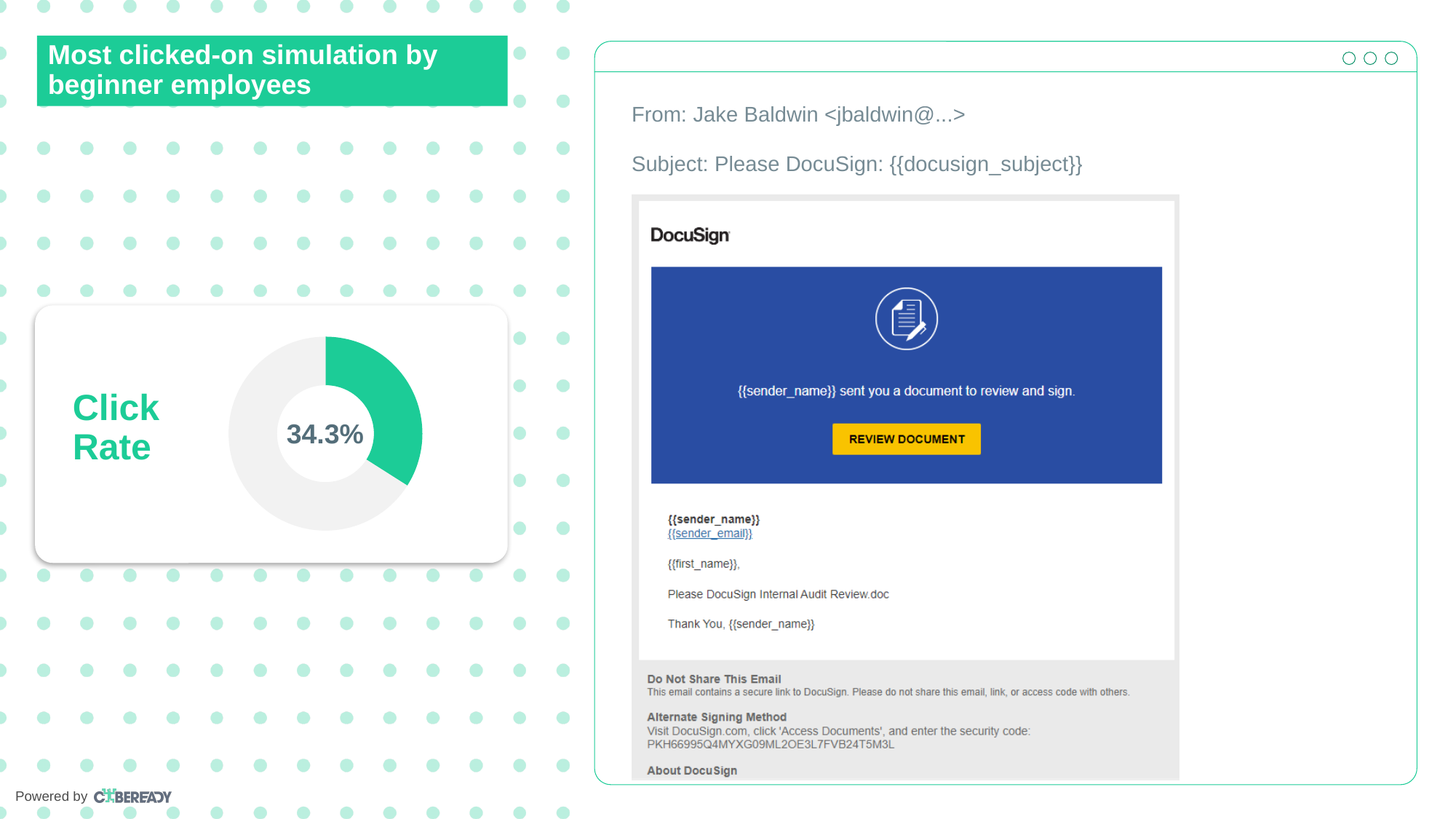
Is the click rate shown in the donut chart greater or less than 50%? less What click rate value is printed in the centre of the donut chart? 34.3% What metric does the donut chart represent, according to the label next to it? Click Rate What share of the donut chart does the green segment represent? 34.3% Is the click rate shown in the donut chart greater or less than 30%? greater How many segments does the donut chart have? 2 What is the title of the slide that the donut chart belongs to? Most clicked-on simulation by beginner employees What kind of chart is shown on the left of the slide under the 'Click Rate' label? Donut (pie) chart In the donut chart, which segment is larger: the green segment or the grey segment? The grey segment